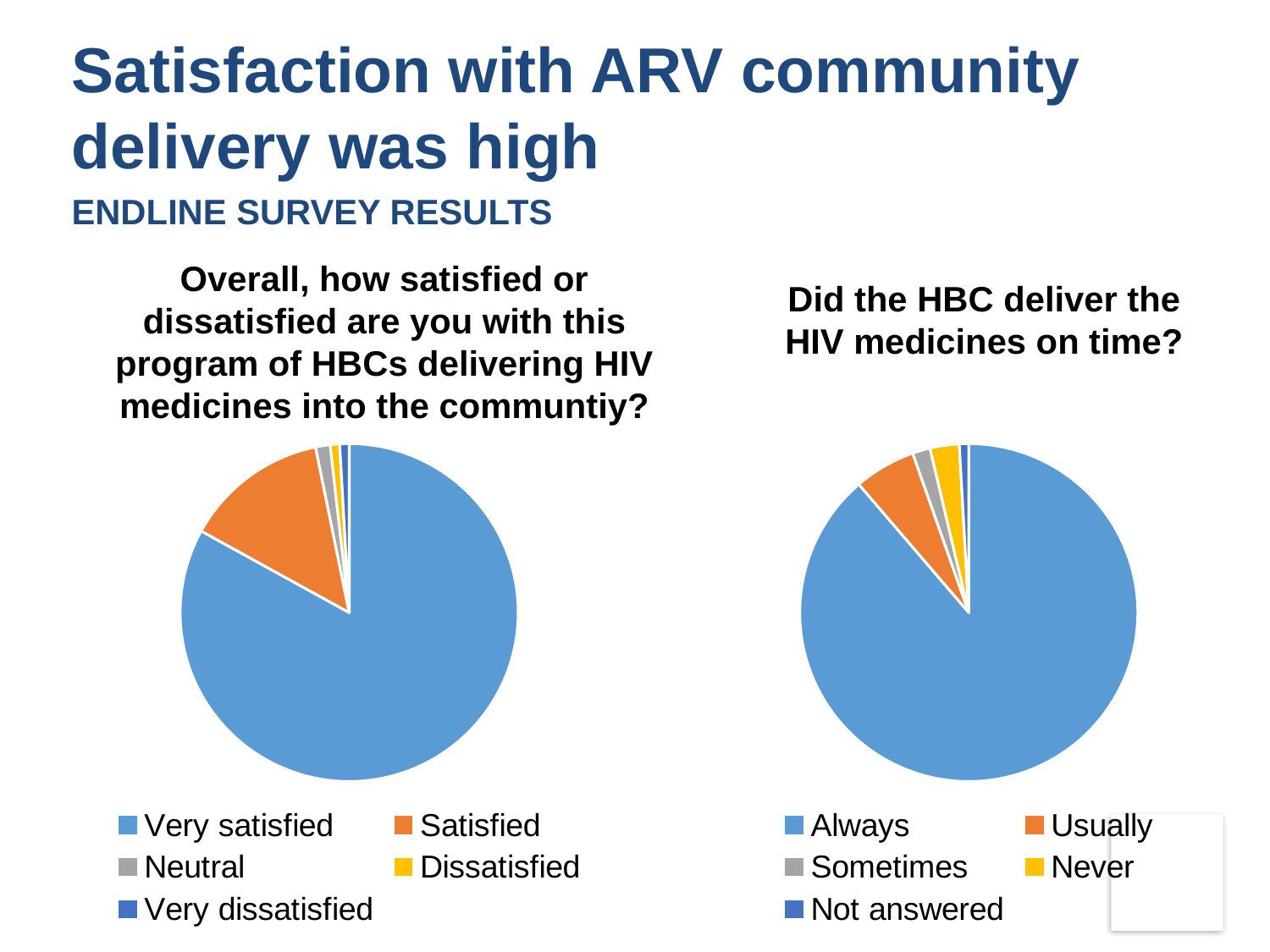
In the right chart ("Did the HBC deliver the HIV medicines on time?"), which slice is larger: Usually or Sometimes? Usually In the left chart (overall satisfaction), how many categories does the legend list? 5 In the left chart (overall satisfaction), what colour is the Satisfied slice? Orange In the right chart ("Did the HBC deliver the HIV medicines on time?"), how many categories does the legend list? 5 In the left chart (overall satisfaction), which slice is larger: Very satisfied or Satisfied? Very satisfied In the right chart ("Did the HBC deliver the HIV medicines on time?"), which category has the largest slice? Always In the left chart (overall satisfaction), which slice is larger: Satisfied or Neutral? Satisfied What kind of chart is the right chart, titled "Did the HBC deliver the HIV medicines on time?"? Pie chart In the left chart (overall satisfaction), which category has the largest slice? Very satisfied In the right chart ("Did the HBC deliver the HIV medicines on time?"), which legend entry is shown in yellow? Never What kind of chart is the left chart, titled "Overall, how satisfied or dissatisfied are you with this program of HBCs delivering HIV medicines into the communtiy?"? Pie chart